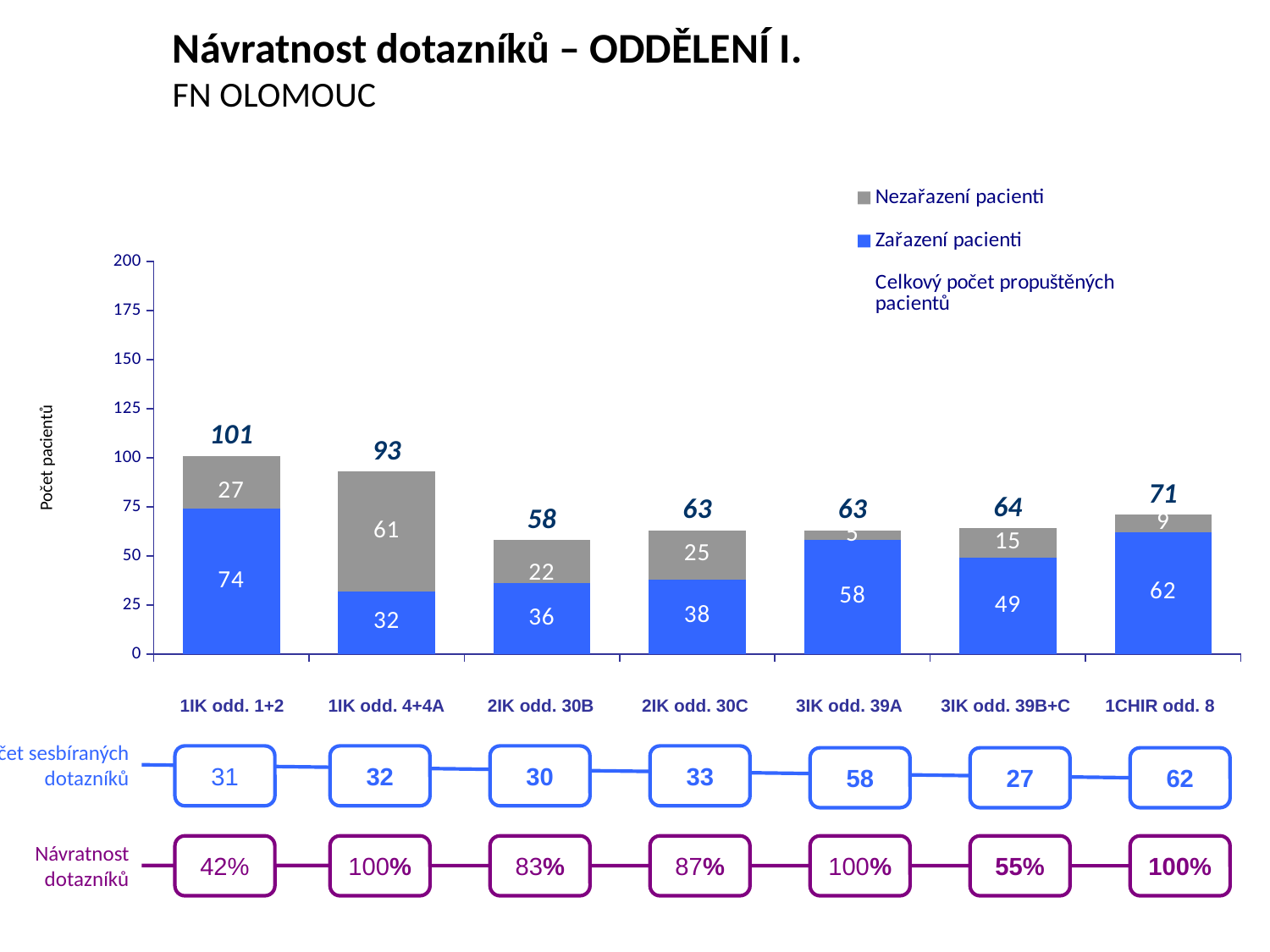
Is the total for 1CHIR odd. 8 greater or less than 75? less What type of chart is shown on the slide? stacked bar chart Which is larger for 1IK odd. 4+4A: Zařazení pacienti or Nezařazení pacienti? Nezařazení pacienti What colour represents Zařazení pacienti in the chart? blue What is the value of Nezařazení pacienti for 1IK odd. 4+4A? 61 What is the value of Zařazení pacienti for 1IK odd. 1+2? 74 How many series does the chart legend list? 3 What is the total number of discharged patients (Celkový počet propuštěných pacientů) for 2IK odd. 30B? 58 Which department has the highest total number of discharged patients? 1IK odd. 1+2 How many departments (categories) are shown on the x axis of the chart? 7 What is the difference between Zařazení pacienti and Nezařazení pacienti for 3IK odd. 39B+C? 34 Which department has the lowest total number of discharged patients? 2IK odd. 30B